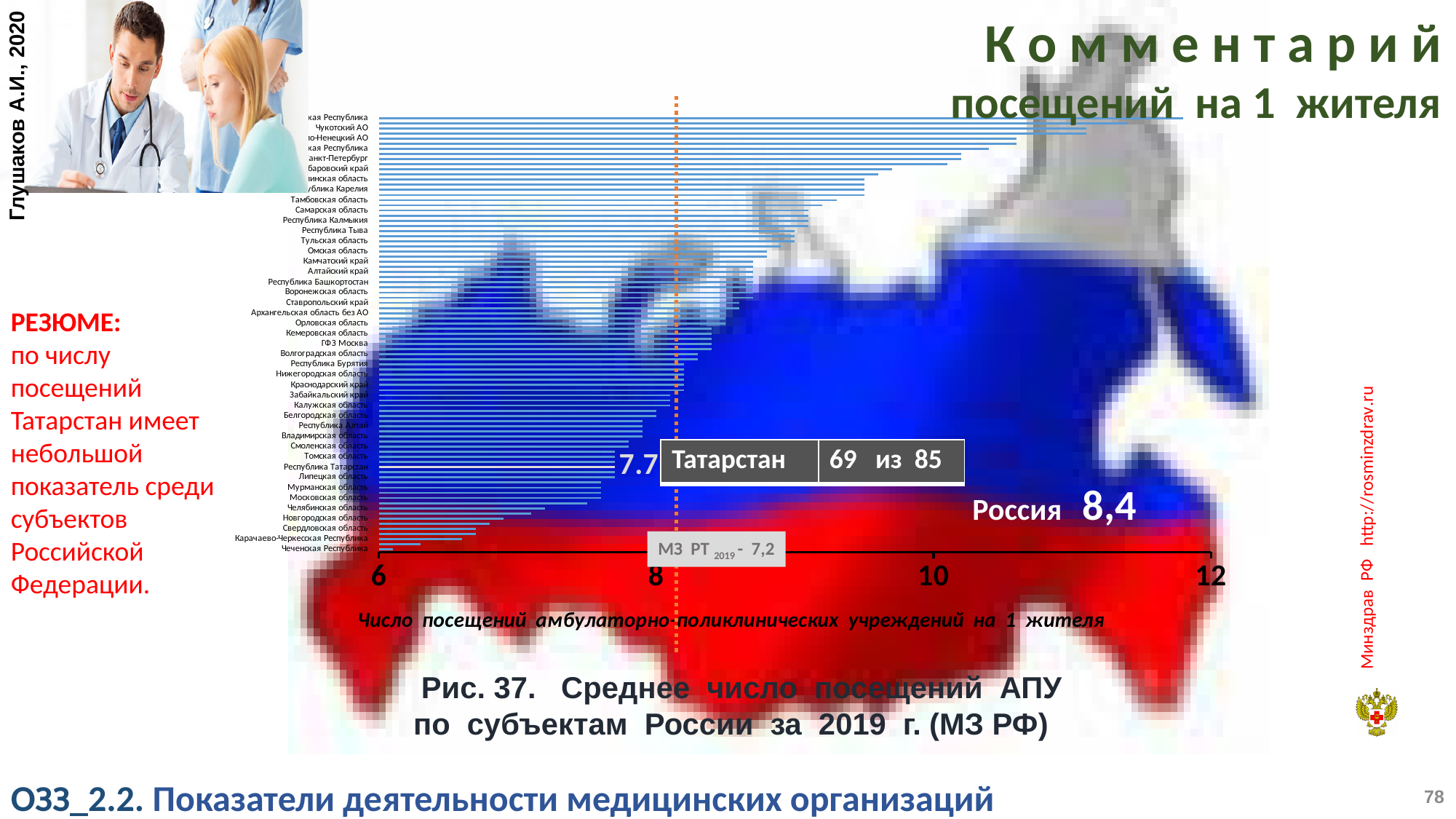
Is the value for Чеченская Республика greater or less than 8? less What is the value shown for Республика Татарстан? 7.7 Do the bar lengths increase or decrease going from the top of the chart to the bottom? decrease Which has the larger value, Чукотский АО or Чеченская Республика? Чукотский АО Is the value for Чукотский АО greater or less than 10? greater Is the value for Тамбовская область greater or less than 8? greater What is the value shown for Россия? 8,4 What rank is shown for Татарстан in the box on the chart? 69 из 85 Which has the larger value, Тамбовская область or Свердловская область? Тамбовская область What kind of chart is shown on the slide? bar chart What is the difference between the value for Россия (8,4) and the value for Республика Татарстан (7.7)? 0.7 Which region has the lowest value on the chart? Чеченская Республика